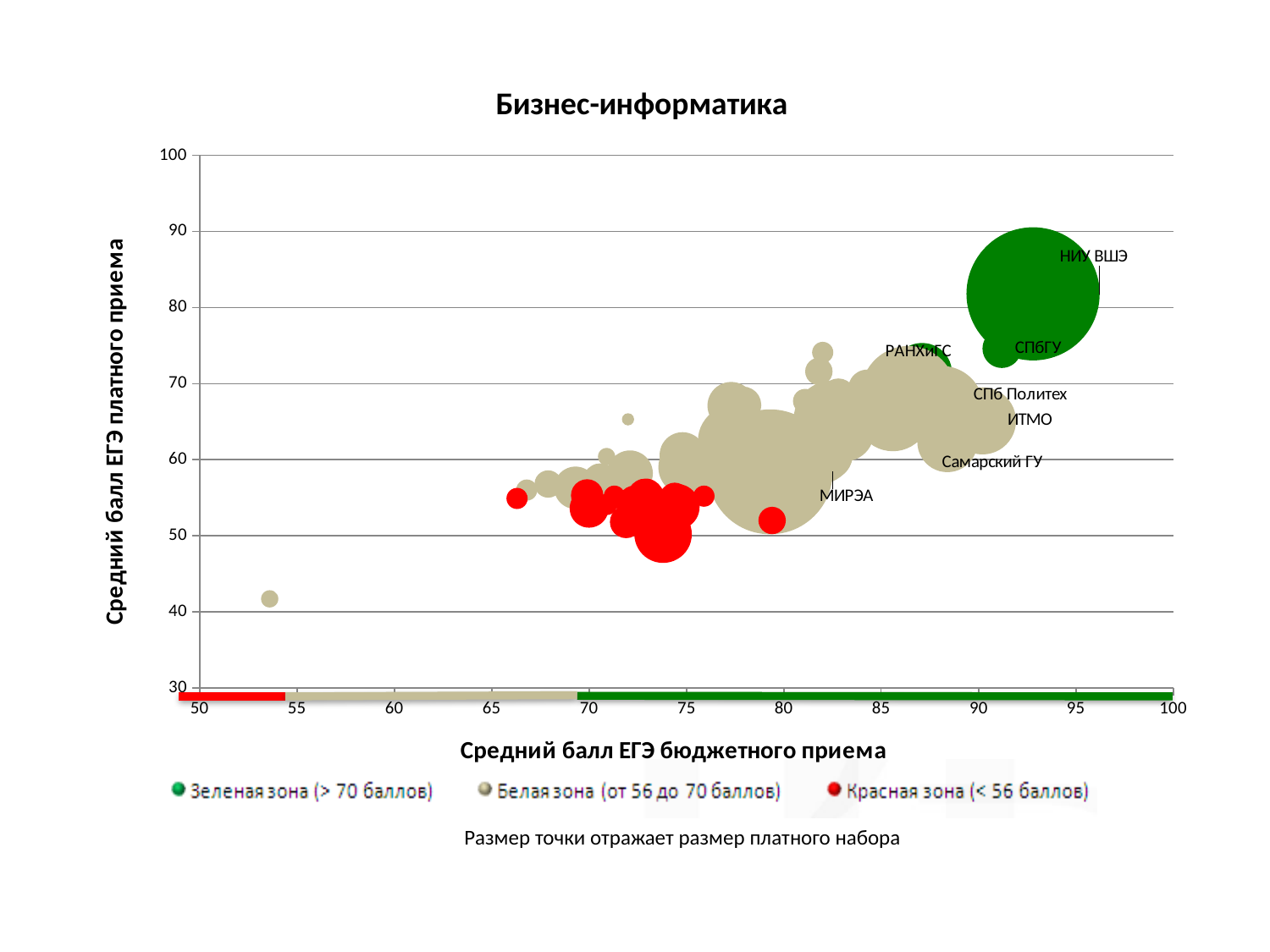
What is the title of the chart? Бизнес-информатика Which has a higher x-axis value, СПбГУ or Самарский ГУ? СПбГУ Which labeled university has the highest value on the y axis (Средний балл ЕГЭ платного приема)? НИУ ВШЭ Is the y-axis value (Средний балл ЕГЭ платного приема) for НИУ ВШЭ greater or less than 70? greater What kind of chart is shown on the slide? Bubble chart Is the y-axis value for МИРЭА greater or less than 70? less Which legend series is shown in red? Красная зона (< 56 баллов) How many series does the legend list? 3 What does the x axis of the chart represent? Средний балл ЕГЭ бюджетного приема Do the y-axis values generally rise or fall as the x-axis value increases? rise Which has a higher y-axis value, НИУ ВШЭ or МИРЭА? НИУ ВШЭ Is the x-axis value (Средний балл ЕГЭ бюджетного приема) for НИУ ВШЭ greater or less than 90? greater